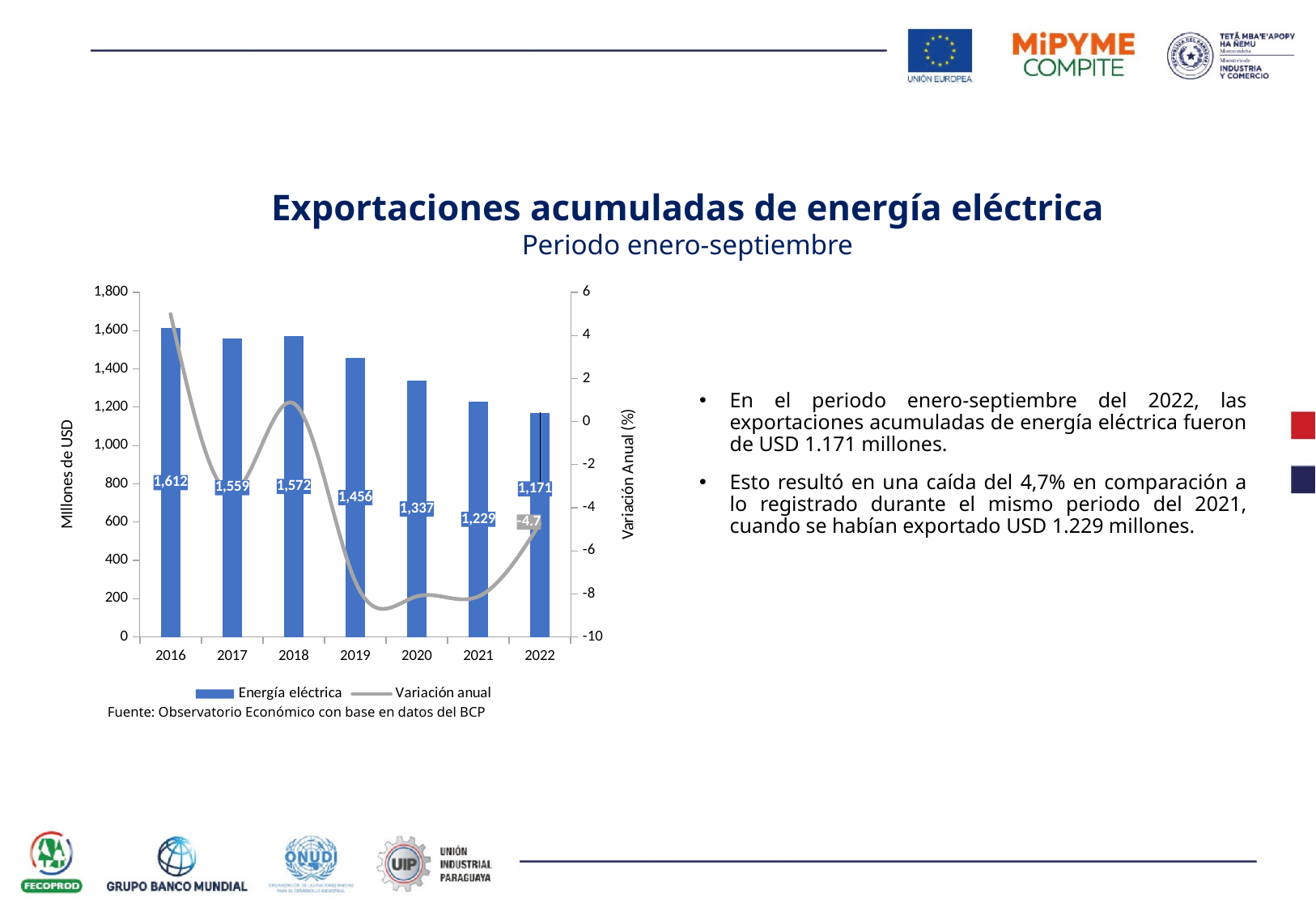
How many years are shown on the x axis? 7 Do the Energía eléctrica values rise or fall from 2018 to 2022? fall How many series does the legend list? 2 What is the Variación anual value shown for 2022? -4.7 Which year has the lowest Energía eléctrica value? 2022 Which is larger, the Energía eléctrica value for 2017 or for 2018? 2018 What is the value of Energía eléctrica for 2019? 1,456 What is the value of Energía eléctrica for 2016? 1,612 Is the Variación anual value for 2019 greater or less than -6? less What is the value of Energía eléctrica for 2022? 1,171 Which year has the highest Energía eléctrica value? 2016 What is the difference between the Energía eléctrica values for 2021 and 2022? 58